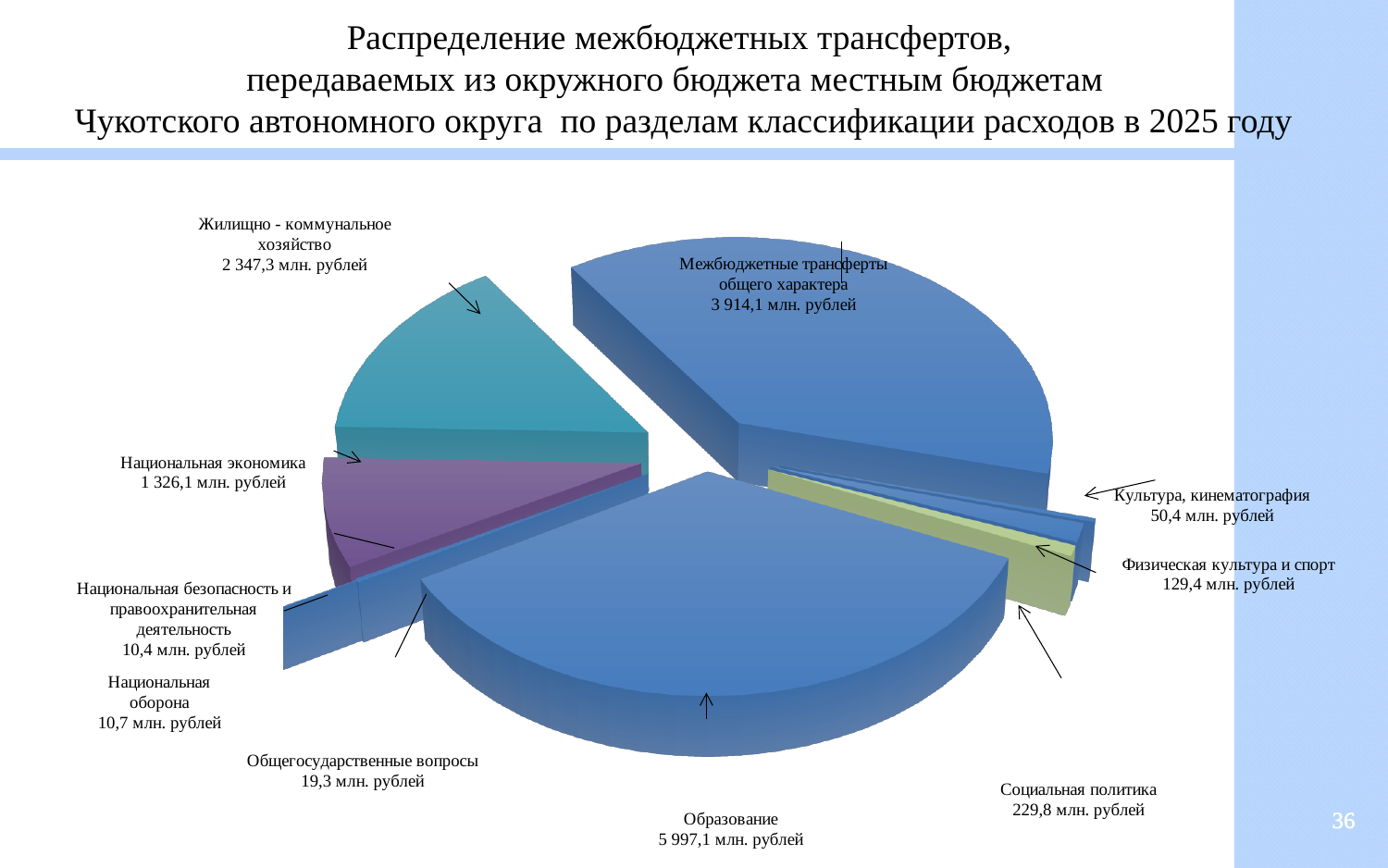
What type of chart is shown on the slide? Pie chart Which category has the largest value in the pie chart? Образование What is the value for Образование? 5 997,1 млн. рублей How many categories (slices) does the pie chart show? 10 For which year does the chart show the distribution of inter-budget transfers? 2025 What is the difference between the values for Образование and Межбюджетные трансферты общего характера? 2 083,0 млн. рублей Which category has the smallest value in the pie chart? Национальная безопасность и правоохранительная деятельность Which is larger: the value for Физическая культура и спорт or the value for Культура, кинематография? Физическая культура и спорт What is the value for Жилищно-коммунальное хозяйство? 2 347,3 млн. рублей What is the difference between the values for Жилищно-коммунальное хозяйство and Национальная экономика? 1 021,2 млн. рублей What is the value for Межбюджетные трансферты общего характера? 3 914,1 млн. рублей What is the value for Социальная политика? 229,8 млн. рублей